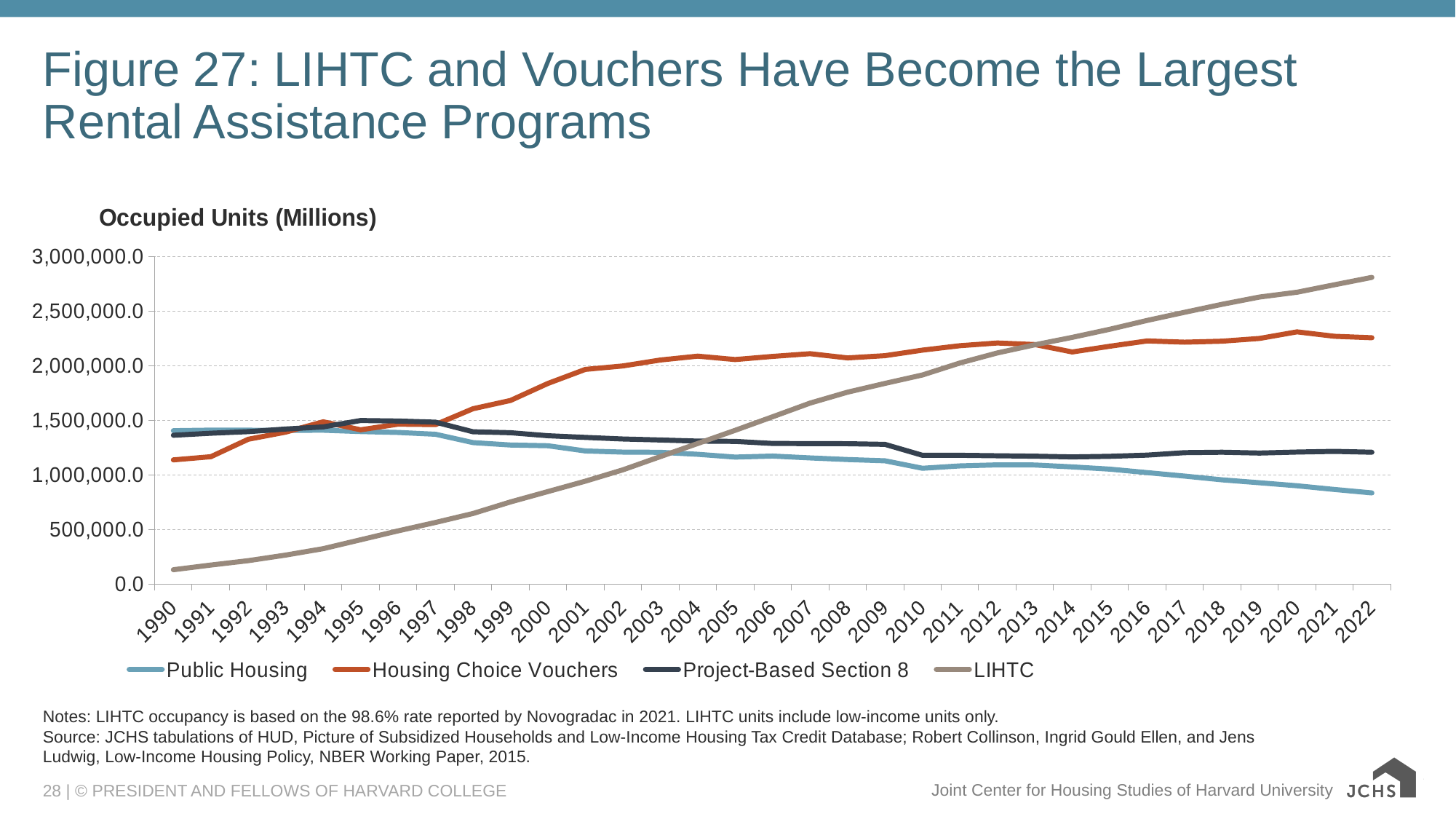
Does the Public Housing line rise or fall from 1990 to 2022? fall Is the value for LIHTC in 2022 greater or less than 2,500,000? greater Does the LIHTC line rise or fall from 1990 to 2022? rise What is the label on the vertical axis of the chart? Occupied Units (Millions) How many years are plotted along the x axis? 33 In 2022, which is larger: LIHTC or Housing Choice Vouchers? LIHTC Is the value for Housing Choice Vouchers in 1990 greater or less than 1,500,000? less Which series has the highest value in 2022? LIHTC Is the value for Public Housing in 2022 greater or less than 1,000,000? less What kind of chart is shown on the slide? line chart How many series does the legend list? 4 Which series has the lowest value in 1990? LIHTC